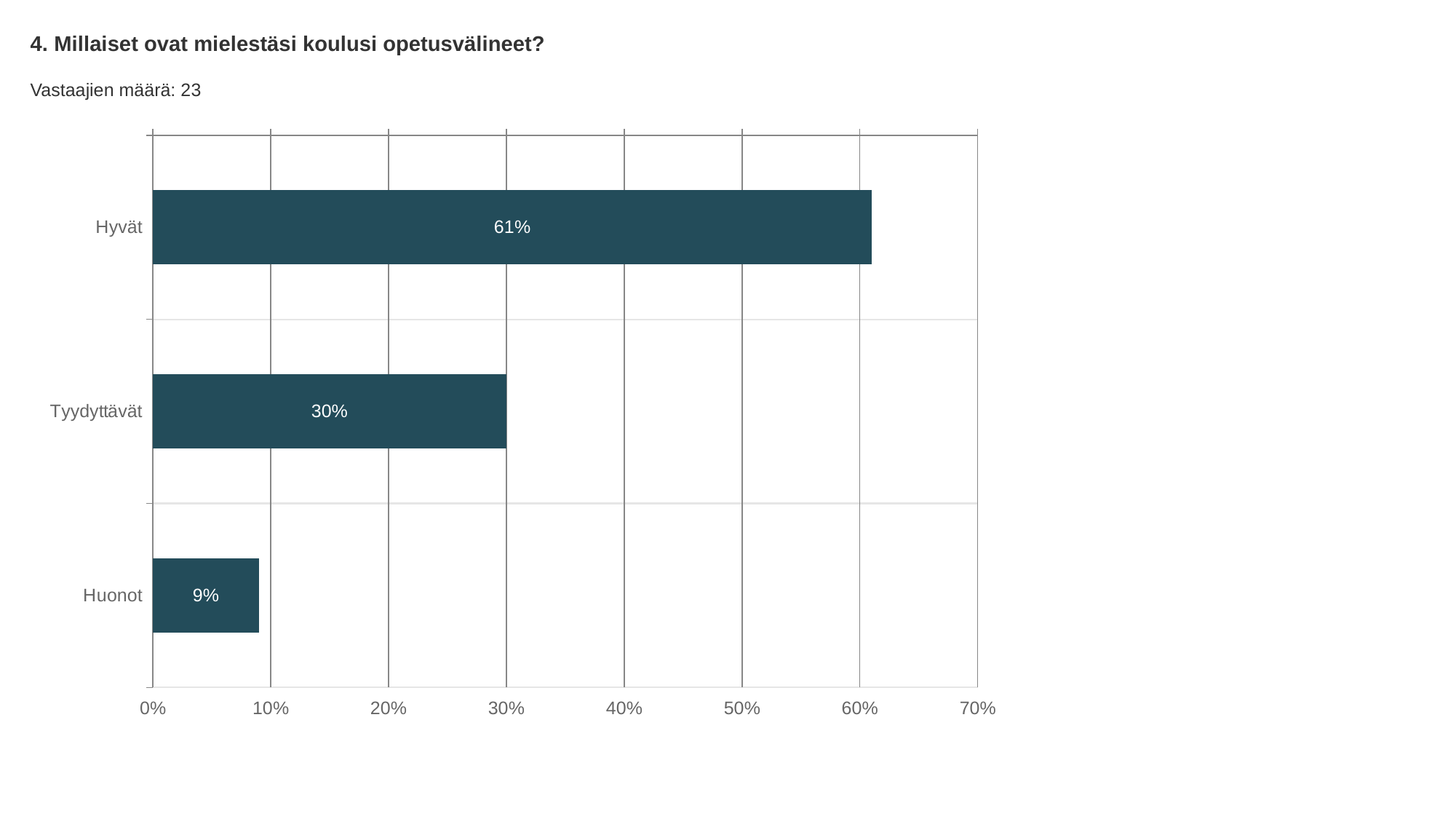
What percentage of respondents answered "Hyvät"? 61% What is the difference in percentage points between "Tyydyttävät" and "Huonot"? 21 Which is larger, the value for "Tyydyttävät" or the value for "Huonot"? Tyydyttävät What kind of chart is shown on the slide? Bar chart Which category has the highest percentage? Hyvät Which category has the lowest percentage? Huonot How many respondents (Vastaajien määrä) are reported on the slide? 23 How many categories are shown in the chart? 3 What is the difference in percentage points between "Hyvät" and "Tyydyttävät"? 31 What percentage of respondents answered "Huonot"? 9% Is the value for "Hyvät" greater or less than 50%? greater What percentage of respondents answered "Tyydyttävät"? 30%